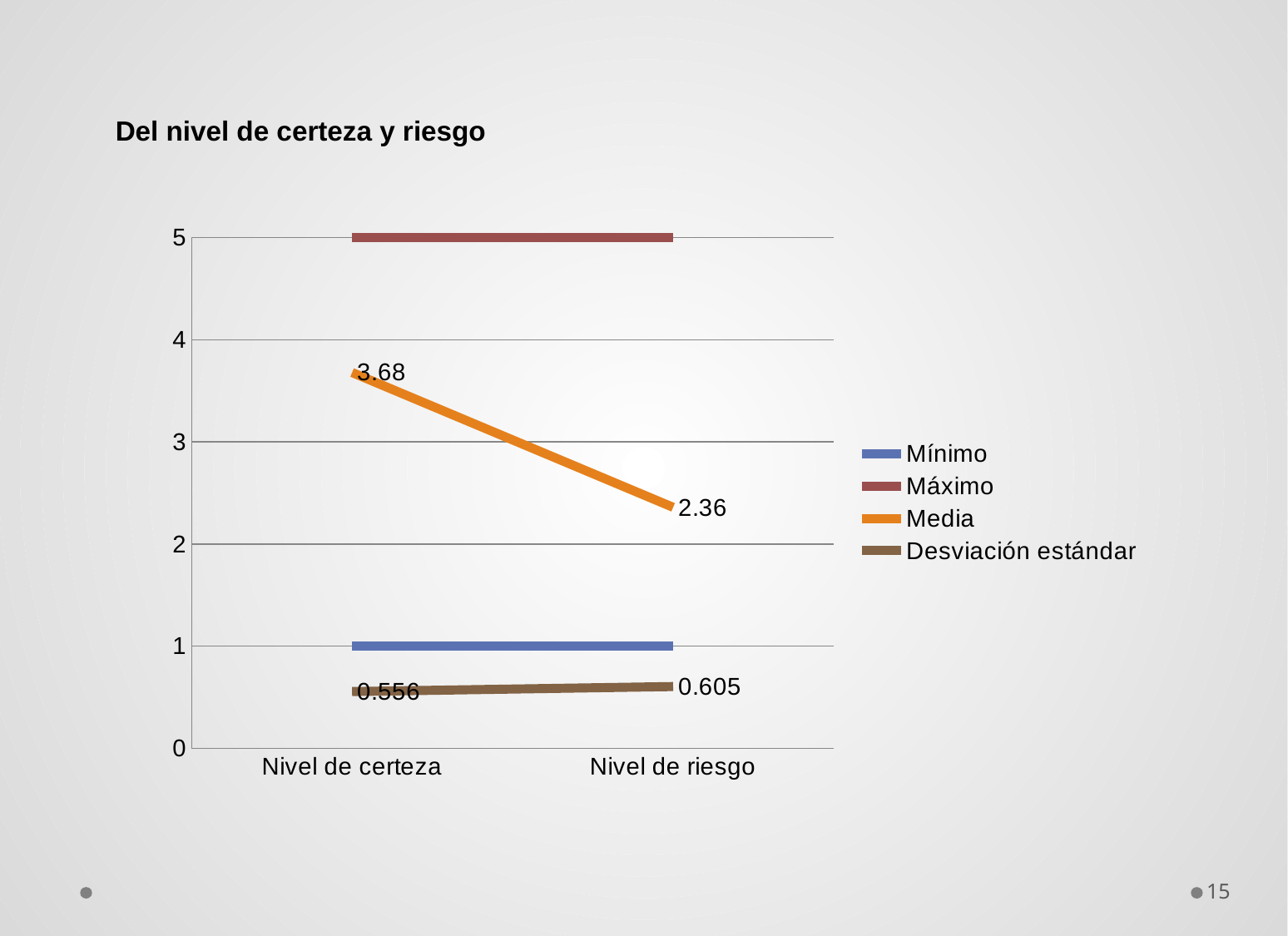
What is the value of Desviación estándar for Nivel de certeza? 0.556 Does the Media series rise or fall from Nivel de certeza to Nivel de riesgo? fall What is the value of the Máximo series for Nivel de riesgo? 5 What is the value of the Media series for Nivel de certeza? 3.68 How many categories are shown on the x axis? 2 What is the value of Desviación estándar for Nivel de riesgo? 0.605 What kind of chart is shown on the slide? line chart What is the value of the Media series for Nivel de riesgo? 2.36 How many series does the legend list? 4 What is the value of the Mínimo series for Nivel de certeza? 1 What is the difference between the Media values for Nivel de certeza and Nivel de riesgo? 1.32 Which category has the higher Media value, Nivel de certeza or Nivel de riesgo? Nivel de certeza